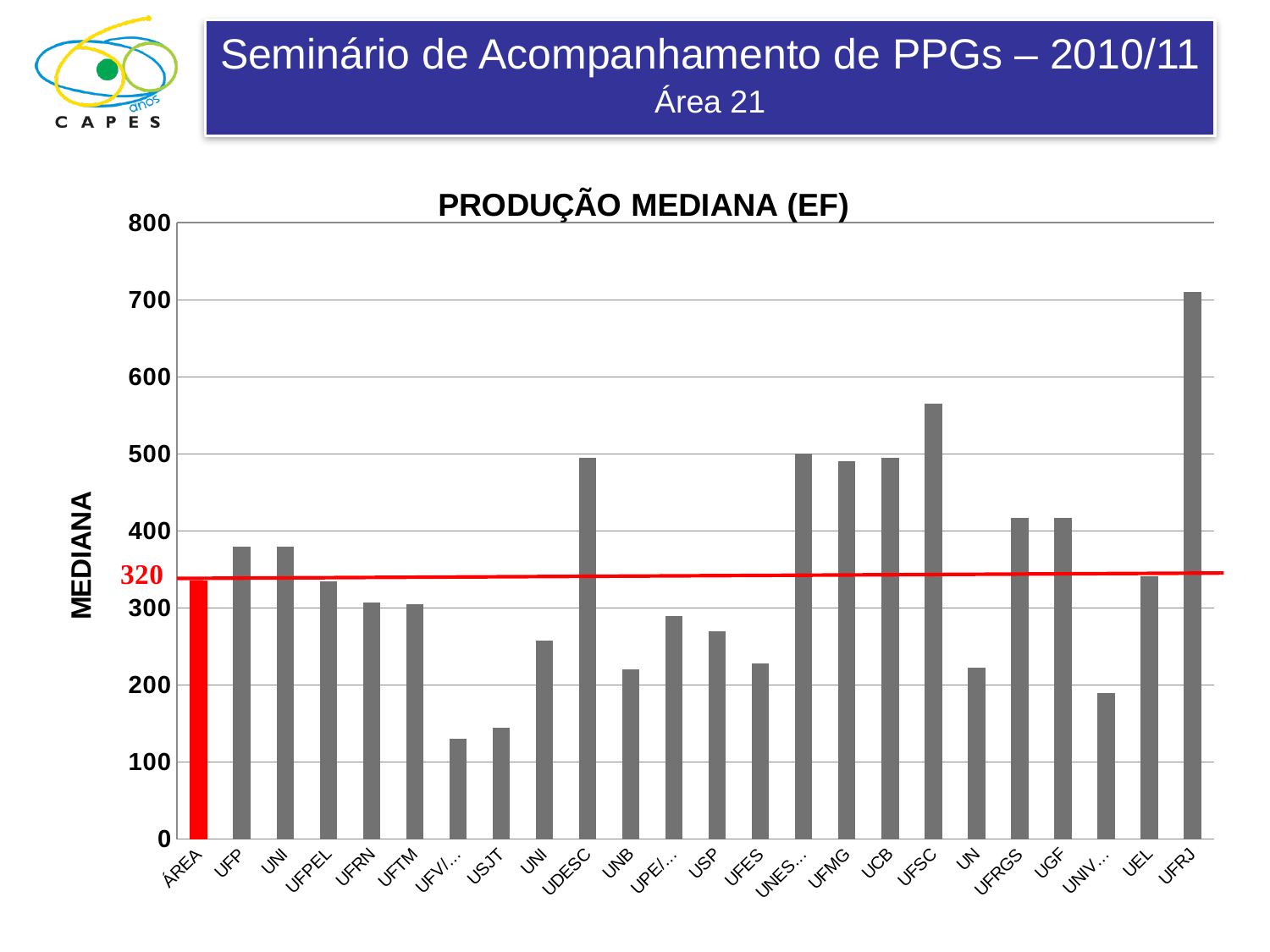
Is the value for UFP greater or less than 400? less Is the value for UFV/... greater or less than 200? less What type of chart is shown on the slide? bar chart Which is larger, the value for UNB or the value for UFV/...? UNB Which category has the highest median production? UFRJ Is the value for UFSC greater or less than 500? greater Which category's bar is coloured red instead of grey? ÁREA What value does the red horizontal reference line mark on the y axis? 320 How many bars are plotted in the chart? 24 What is the title of the chart? PRODUÇÃO MEDIANA (EF) Which is larger, the value for UFSC or the value for UFMG? UFSC